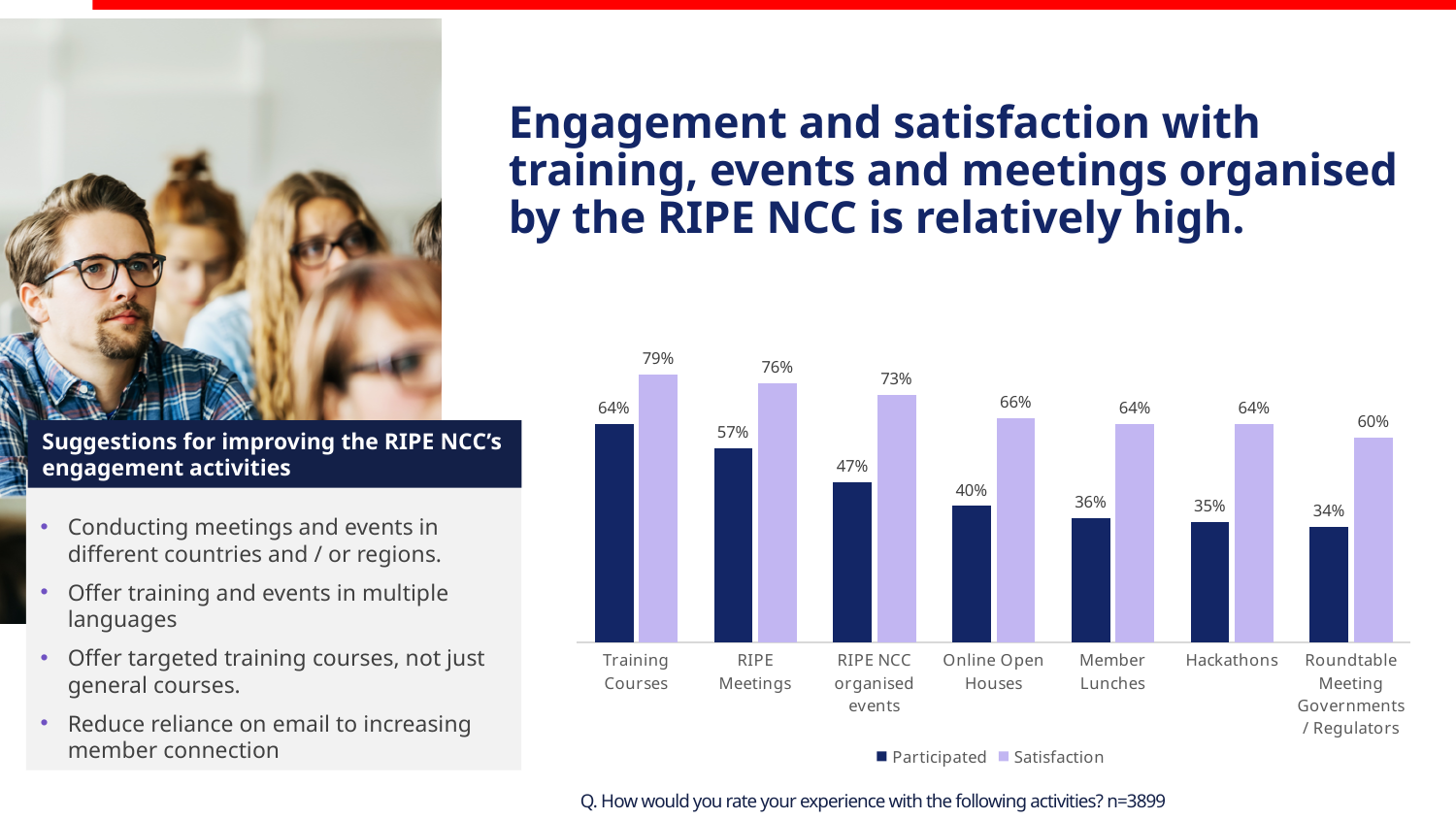
Which category has the lowest Participated value? Roundtable Meeting Governments / Regulators What kind of chart is shown on the slide? Bar chart What is the Participated value for Training Courses? 64% What is the Participated value for Online Open Houses? 40% What is the Satisfaction value for Roundtable Meeting Governments / Regulators? 60% Do the Participated values rise or fall from left to right along the x axis? Fall Which is larger: the Participated value for RIPE Meetings or the Participated value for Member Lunches? RIPE Meetings How many series does the chart's legend list? 2 How many categories are shown on the x axis of the chart? 7 What is the difference between the Satisfaction and Participated values for RIPE NCC organised events? 26% Which category has the highest Satisfaction value? Training Courses What is the Satisfaction value for RIPE Meetings? 76%